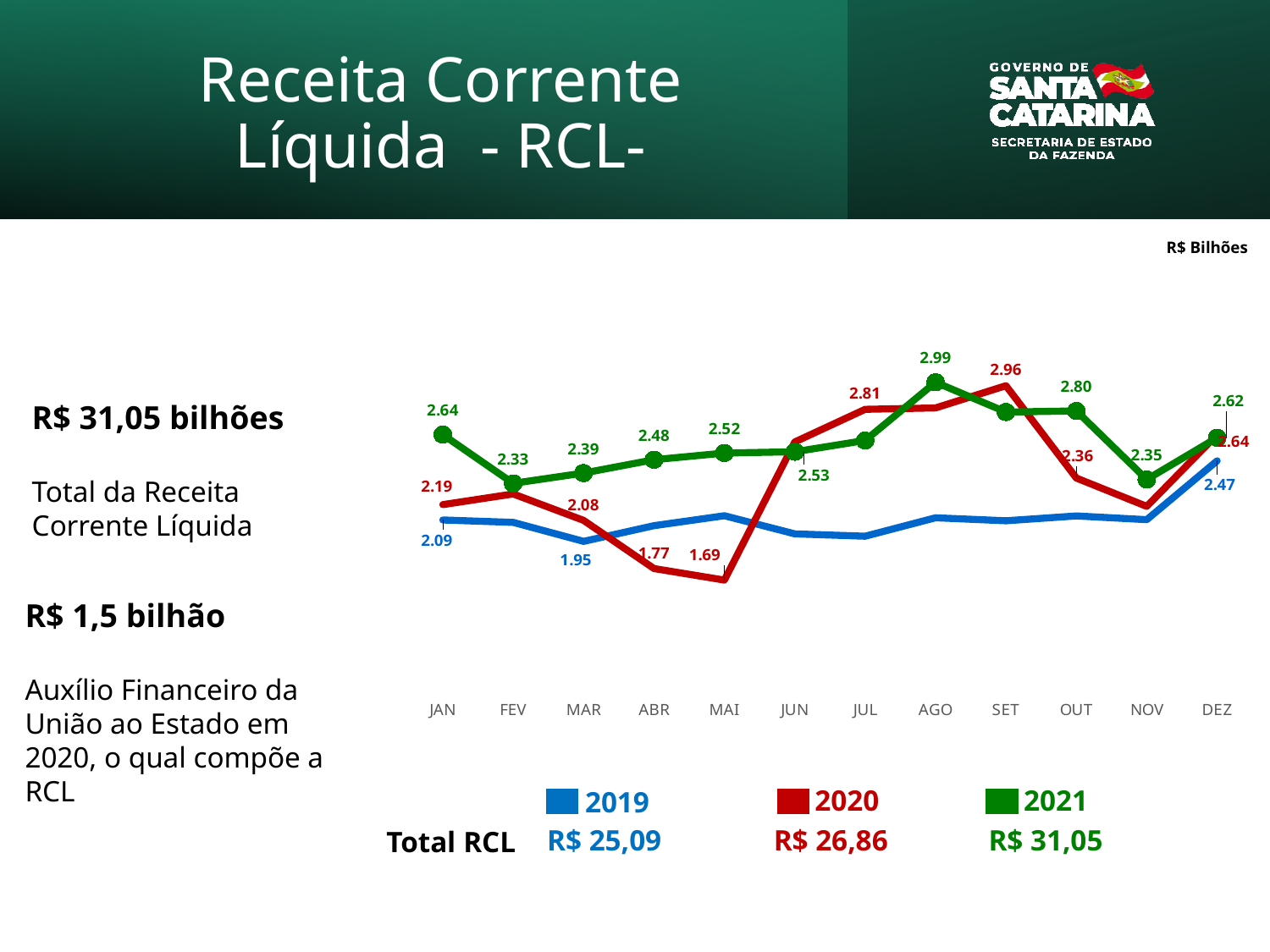
What is the value for 2020 in MAI? 1.69 What is the Total RCL shown for 2021? R$ 31,05 Does the 2020 series rise or fall from MAR to MAI? fall How many months are shown on the x axis? 12 How many series does the legend list? 3 What is the value for 2019 in DEZ? 2.47 In which month does the 2020 series reach its lowest value? MAI Which is larger: the 2019 value in JAN or the 2020 value in JAN? 2020 What is the value for 2021 in AGO? 2.99 What is the difference between the 2021 and 2020 values in JAN? 0.45 In which month does the 2021 series reach its highest value? AGO What kind of chart is shown on the slide? line chart